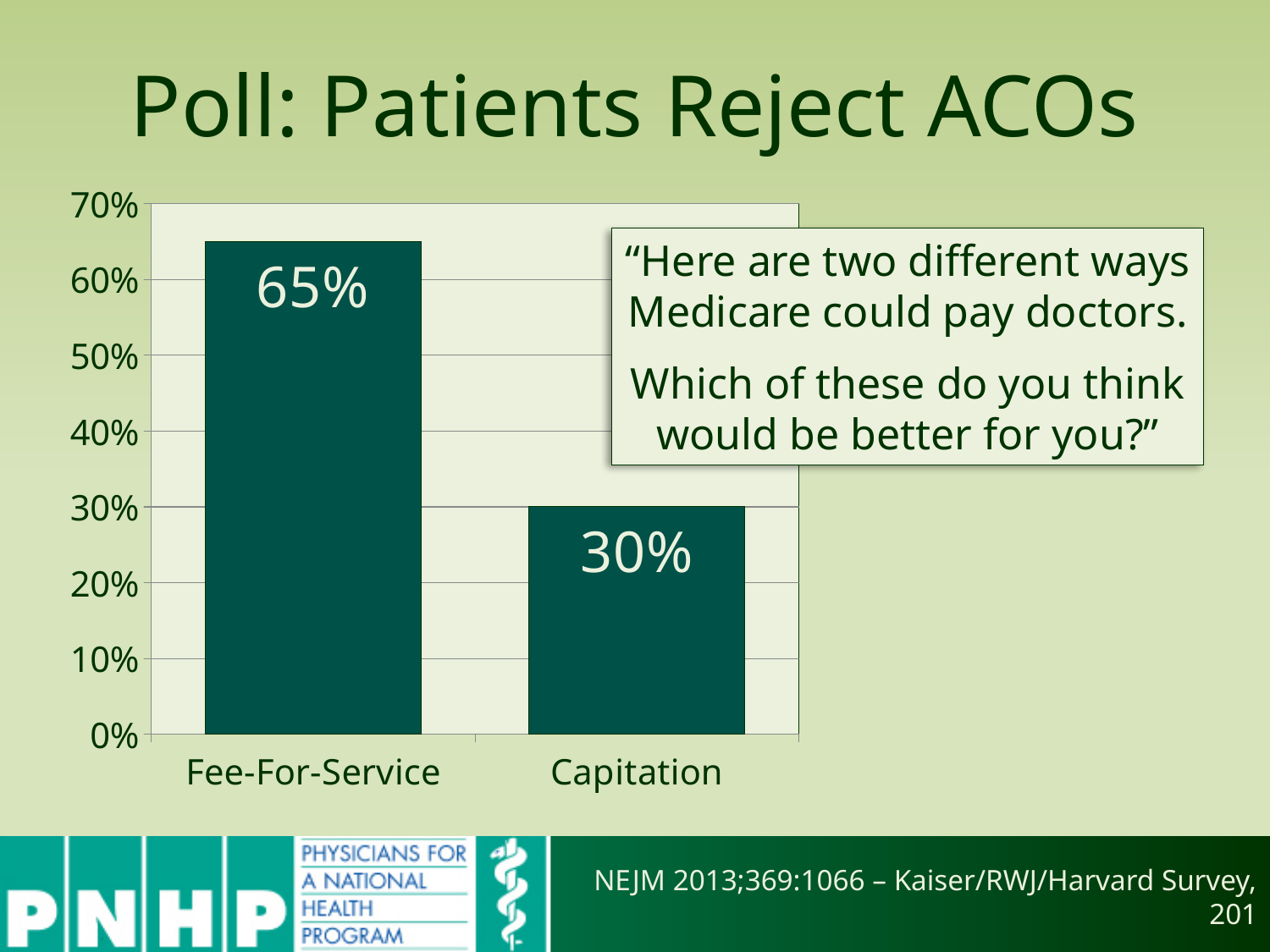
What is the title of the slide? Poll: Patients Reject ACOs Which is larger, the value for Fee-For-Service or the value for Capitation? Fee-For-Service Which category has the lowest value? Capitation How many categories are shown on the chart? 2 What is the highest value shown on the vertical axis? 70% Is the value for Fee-For-Service greater or less than 60%? greater What is the value for Capitation? 30% What is the value for Fee-For-Service? 65% Is the value for Capitation greater or less than 40%? less What is the difference between the values for Fee-For-Service and Capitation? 35% Which category has the highest value? Fee-For-Service What kind of chart is shown on the slide? bar chart